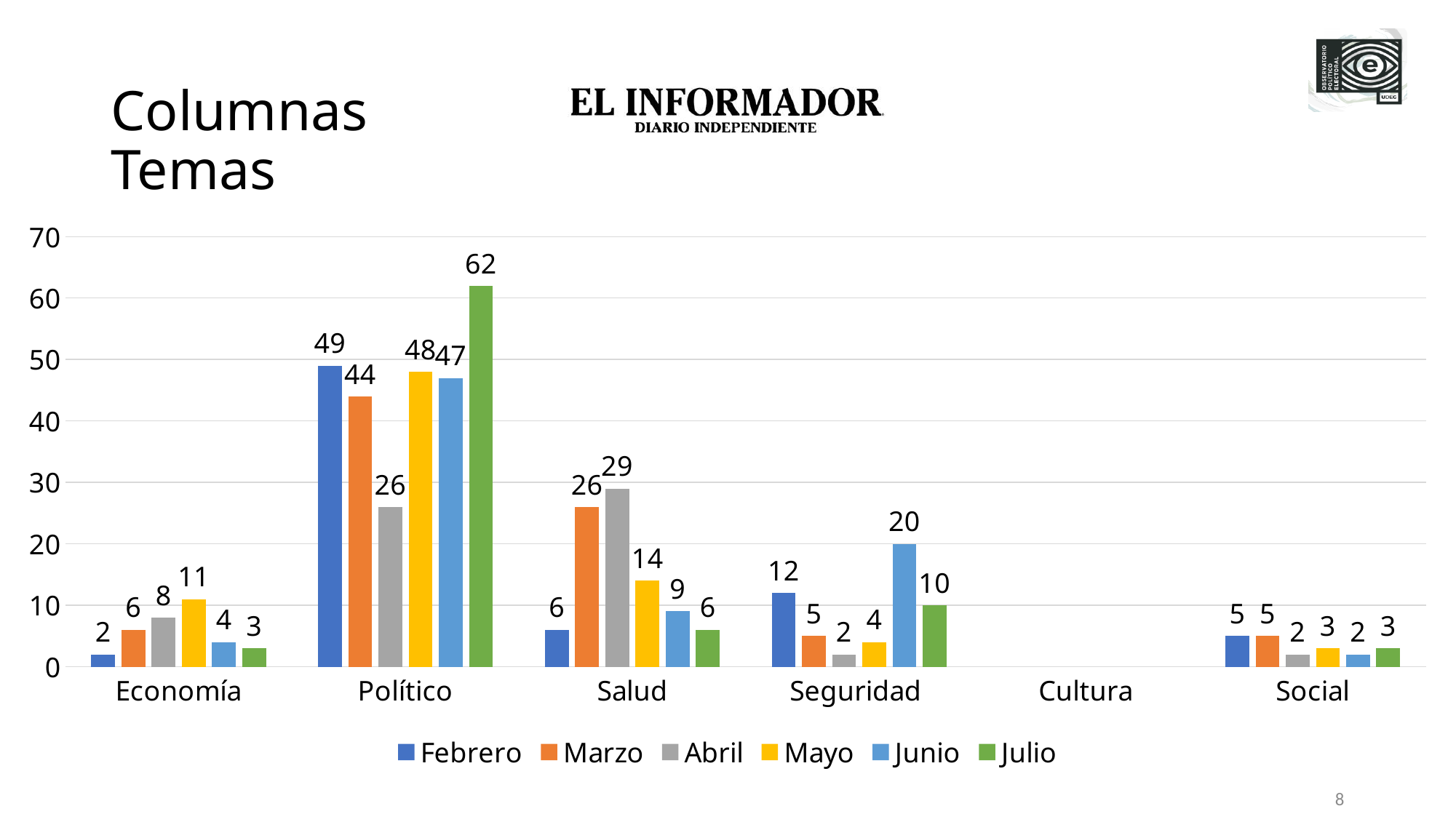
How many series does the legend list? 6 Which is larger in the Salud category: the Marzo value or the Mayo value? Marzo What kind of chart is shown on the slide? bar chart How many categories are shown on the x axis? 6 What is the value for Julio in the Político category? 62 Which month has the lowest value in the Economía category? Febrero What is the difference between the Febrero and Marzo values in the Político category? 5 What is the value for Abril in the Salud category? 29 What is the value for Junio in the Seguridad category? 20 Which month has the highest value in the Político category? Julio Is the value for Abril in the Político category greater or less than 30? less Which colour represents Julio in the legend? green